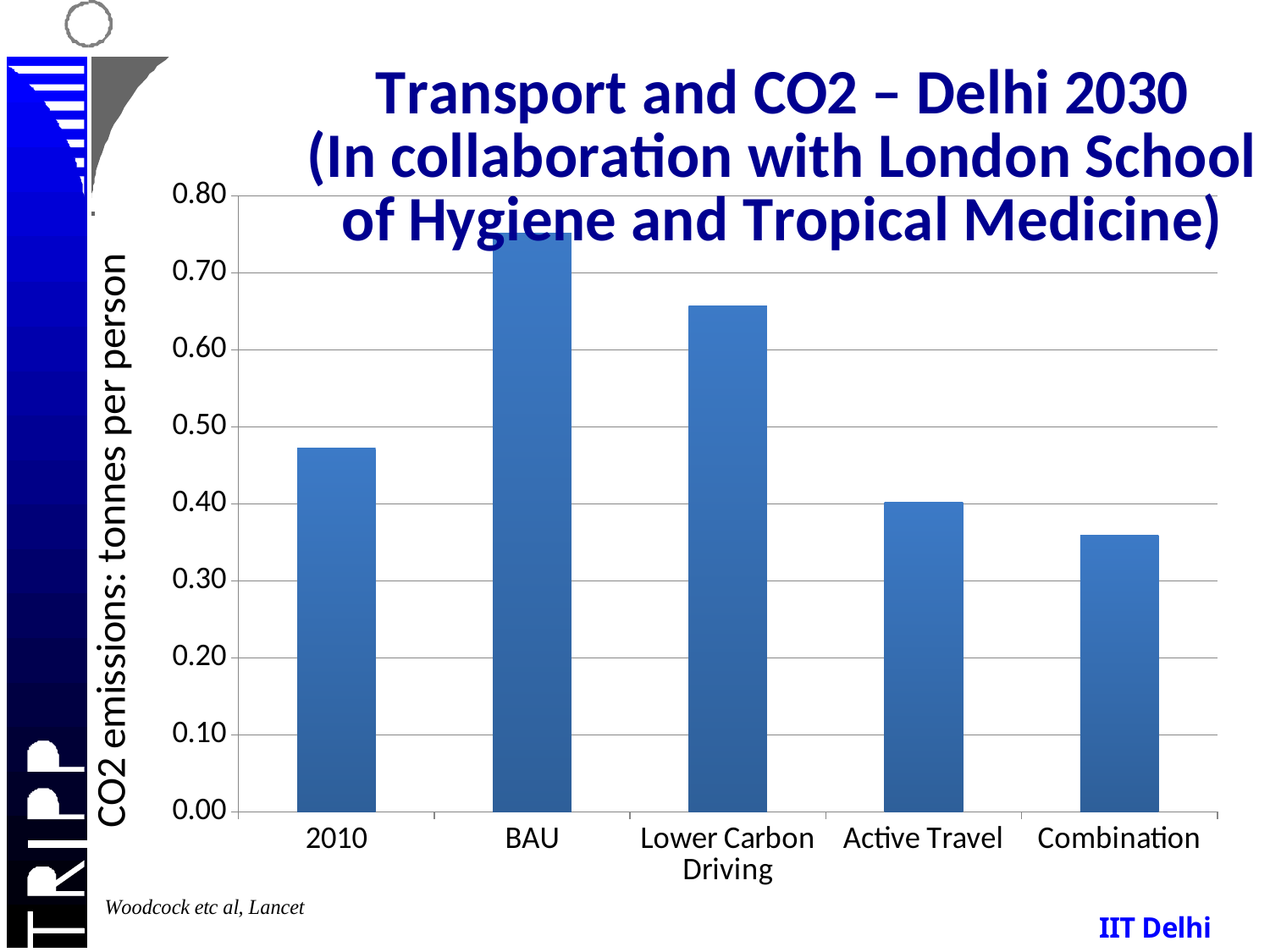
What is the label on the vertical axis of the chart? CO2 emissions: tonnes per person Is the value for 2010 greater or less than 0.50? less Is the value for Lower Carbon Driving greater or less than 0.60? greater Do the values rise or fall along the x axis from BAU to Combination? fall Which is larger, the value for BAU or the value for Lower Carbon Driving? BAU Is the value for BAU greater or less than 0.70? greater How many categories are shown on the x axis of the chart? 5 Which category has the lowest CO2 emissions per person? Combination What kind of chart is shown on the slide? bar chart Which is larger, the value for 2010 or the value for Active Travel? 2010 Which category has the highest CO2 emissions per person? BAU